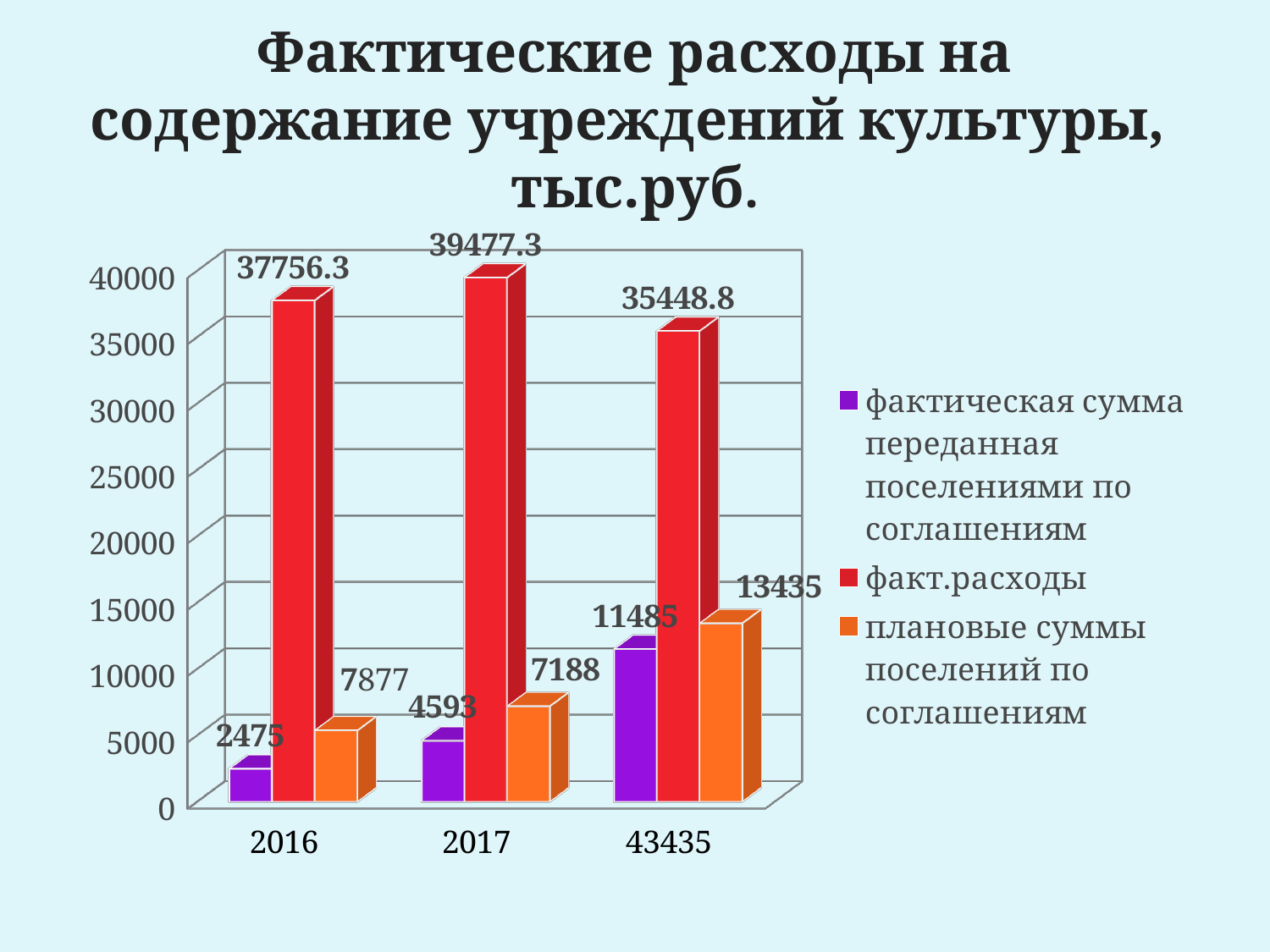
How many categories are shown on the x axis? 3 What kind of chart is shown on the slide? bar chart Which is larger for 2016: плановые суммы поселений по соглашениям or фактическая сумма переданная поселениями по соглашениям? плановые суммы поселений по соглашениям What is the difference between факт.расходы in 2017 and in 2016? 1721 What is the difference between плановые суммы поселений по соглашениям and фактическая сумма переданная поселениями по соглашениям for the category labelled 43435? 1950 What is the value of фактическая сумма переданная поселениями по соглашениям for the category labelled 43435? 11485 What is the value of плановые суммы поселений по соглашениям for 2017? 7188 Does фактическая сумма переданная поселениями по соглашениям rise or fall across the categories from left to right? rise How many series does the legend list? 3 What is the value of факт.расходы for 2016? 37756.3 In which category is факт.расходы highest? 2017 In which category is фактическая сумма переданная поселениями по соглашениям lowest? 2016